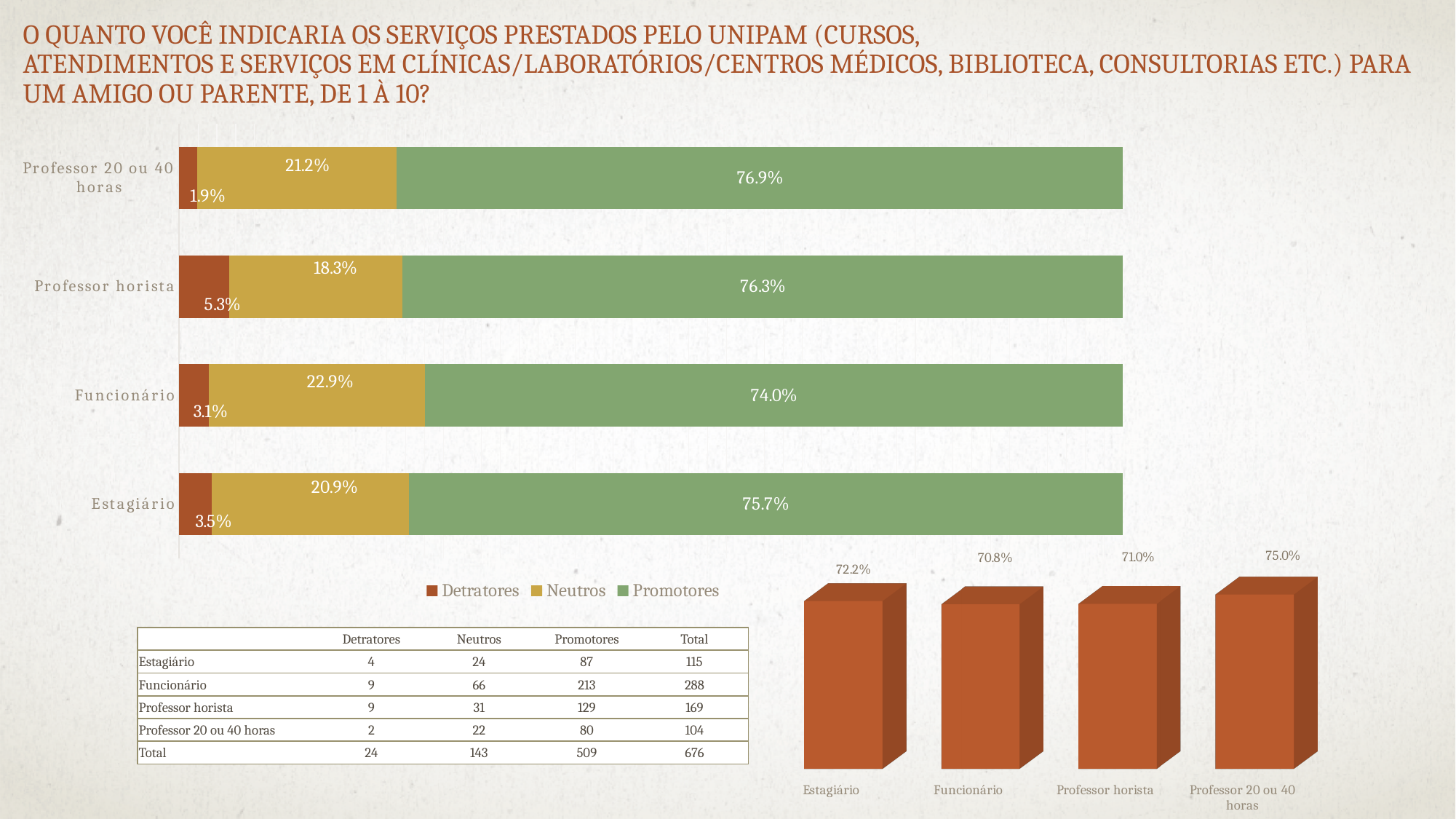
In the stacked bar chart, which colour represents Promotores in the legend? Green How many categories does the stacked bar chart show? 4 How many series does the legend of the stacked bar chart list? 3 In the stacked bar chart, which has the larger Neutros value: Estagiário or Professor 20 ou 40 horas? Professor 20 ou 40 horas In the stacked bar chart, what is the difference between the Neutros values for Funcionário and Professor horista? 4.6 percentage points In the stacked bar chart, which category has the lowest Detratores value? Professor 20 ou 40 horas In the bottom-right bar chart, which category has the lowest value? Funcionário In the stacked bar chart, what is the Detratores value for Funcionário? 3.1% In the stacked bar chart, which category has the highest Promotores value? Professor 20 ou 40 horas In the stacked bar chart, what is the Promotores value for Professor horista? 76.3% What kind of chart is the chart at the bottom right of the slide? Bar chart In the bottom-right bar chart, what is the value for Professor 20 ou 40 horas? 75.0%